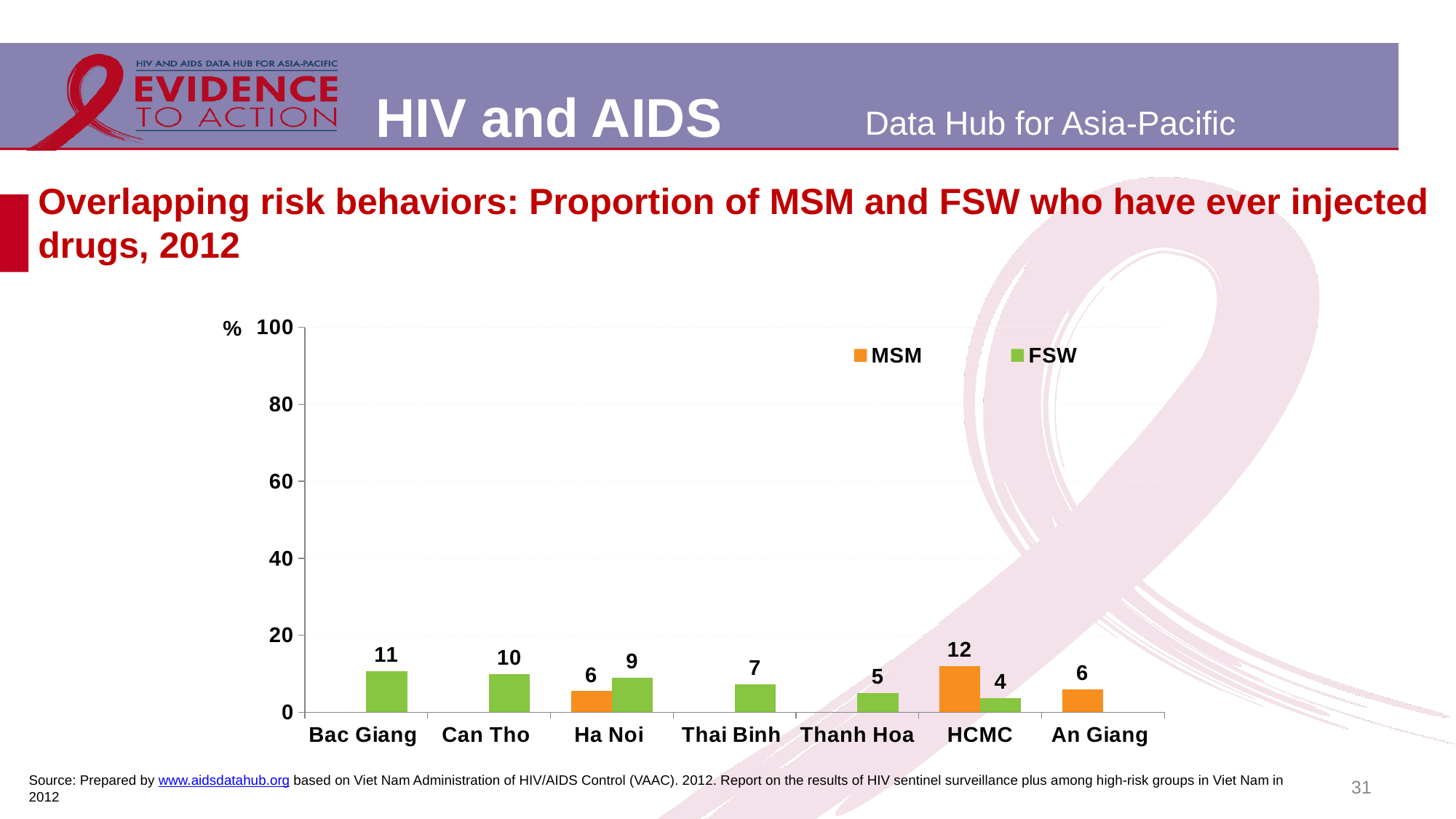
What kind of chart is shown on the slide? bar chart How many provinces are shown on the x axis? 7 Which province has the highest FSW value? Bac Giang What is the MSM value for An Giang? 6 How many series does the legend list? 2 What is the FSW value for Bac Giang? 11 What is the MSM value for HCMC? 12 What is the FSW value for Ha Noi? 9 Which province has the lowest FSW value? HCMC In Ha Noi, which is larger, the MSM value or the FSW value? FSW Is the MSM value for HCMC greater or less than 20? less What is the difference between the MSM and FSW values for HCMC? 8